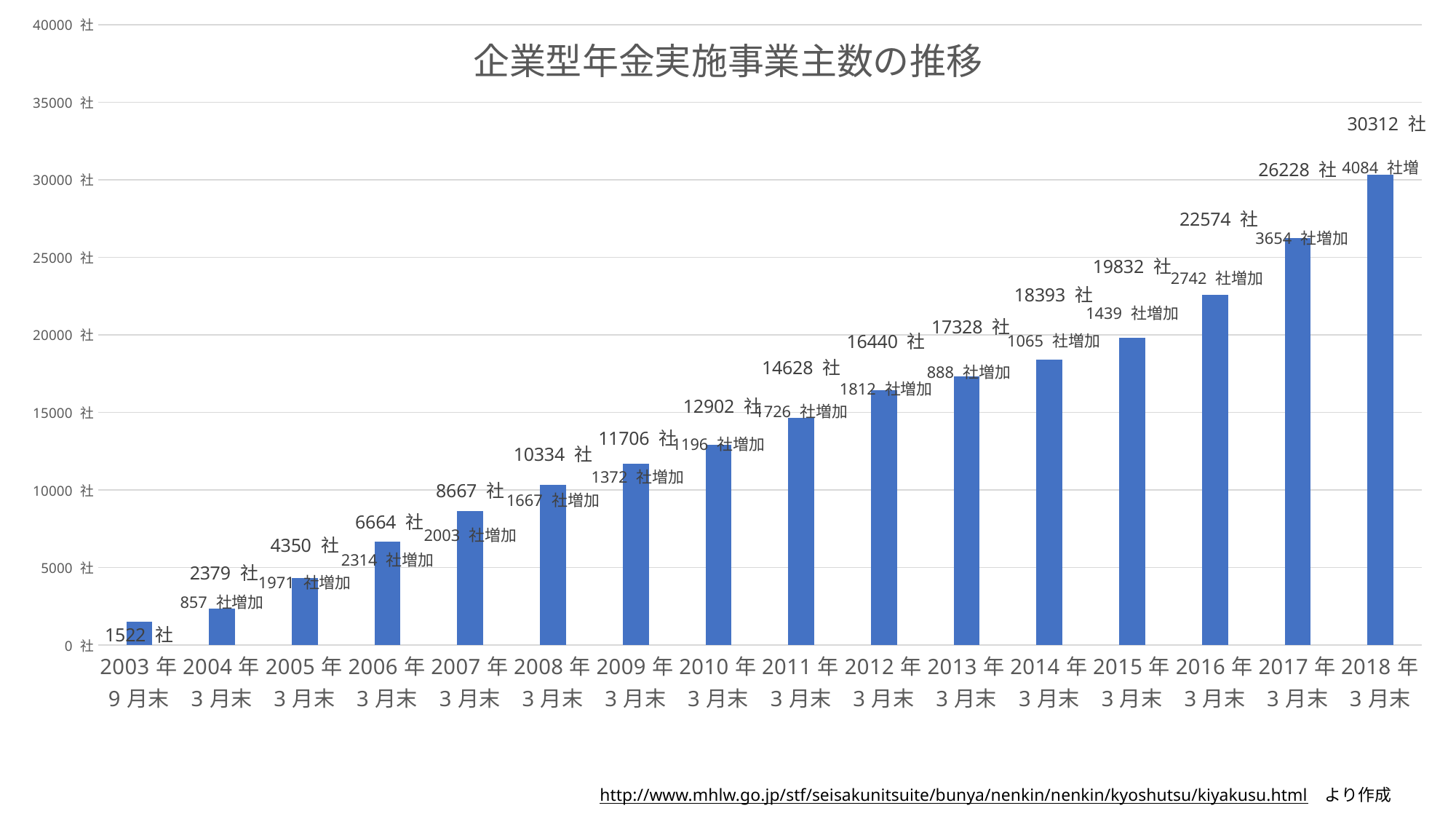
What is the difference between the values for 2008年3月末 and 2007年3月末? 1667 社 What is the difference between the values for 2018年3月末 and 2017年3月末? 4084 社 Is the value for 2016年3月末 greater or less than 20000? greater Which is larger, the value for 2012年3月末 or the value for 2013年3月末? 2013年3月末 Which category has the highest value? 2018年3月末 What is the value for 2010年3月末? 12902 社 How many bars are shown in the chart? 16 Which category has the lowest value? 2003年9月末 Do the values rise or fall from 2003年9月末 to 2018年3月末? rise What is the value for 2003年9月末? 1522 社 What kind of chart is this? bar chart What is the value for 2018年3月末? 30312 社